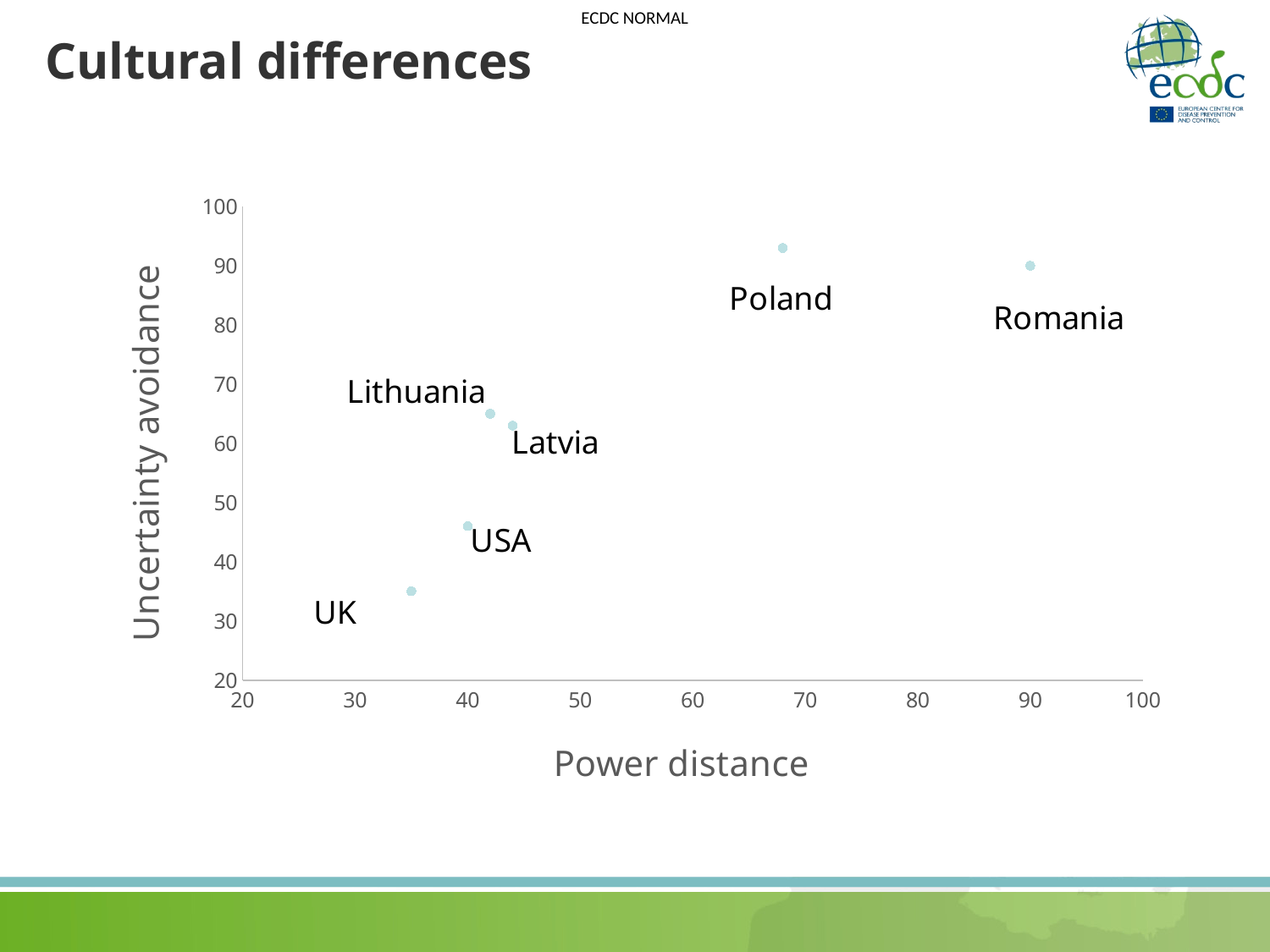
Which country has the lowest uncertainty avoidance? UK Which has the higher uncertainty avoidance, Poland or the USA? Poland How many countries are plotted on the chart? 6 What kind of chart is shown on the slide? scatter chart Is the uncertainty avoidance value for the USA greater or less than 50? less What is the label of the horizontal axis? Power distance Which country has the highest power distance? Romania Which country has the lowest power distance? UK What is the power distance value for Romania? 90 Which country has the highest uncertainty avoidance? Poland Is the uncertainty avoidance value for Poland greater or less than 90? greater Is the power distance value for the UK greater or less than 40? less